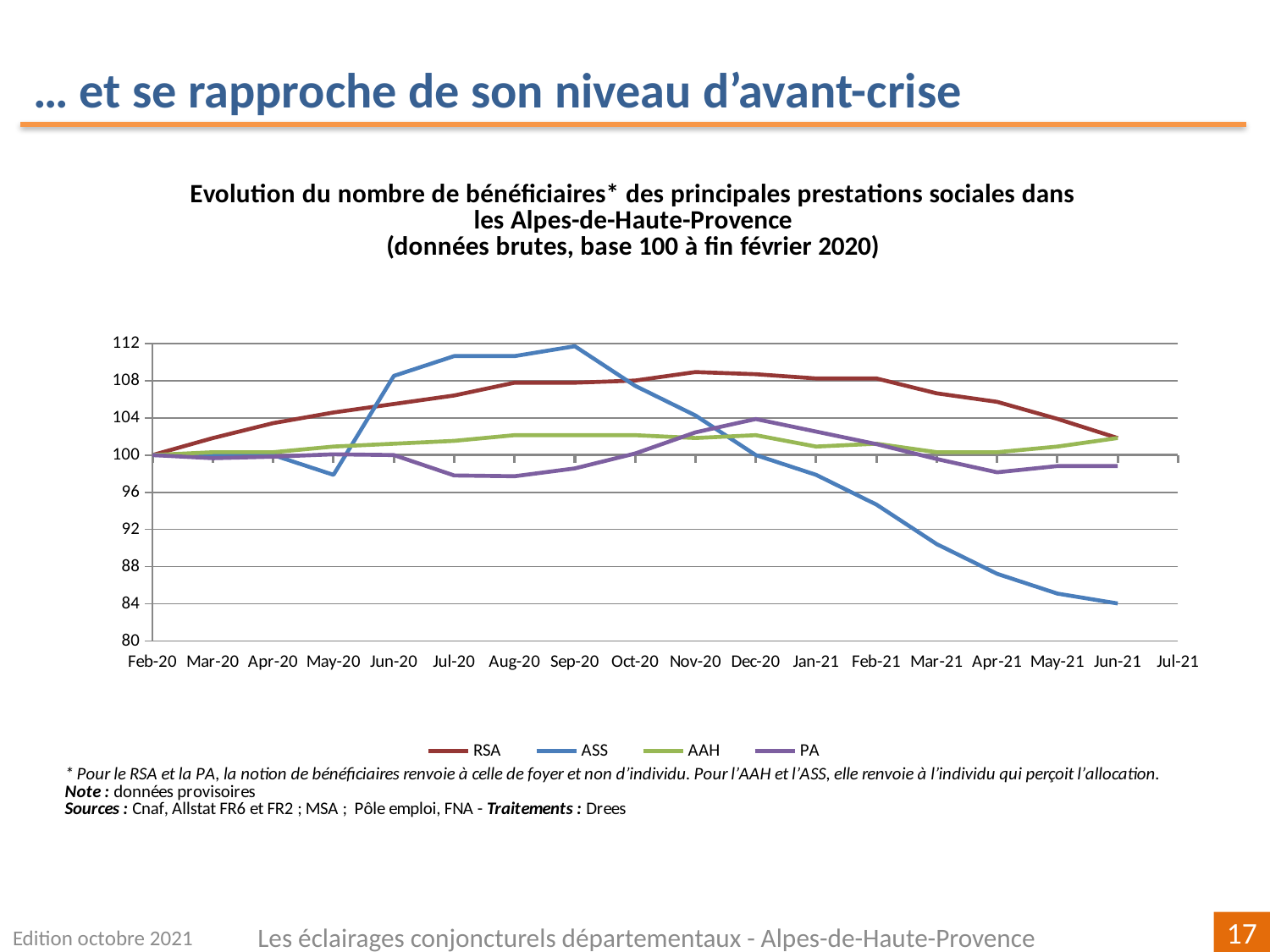
Is the value of the PA series at Jul-20 greater or less than 100? less Does the ASS series rise or fall between Sep-20 and Jun-21? fall Which series has the highest value at Sep-20? ASS At Jan-21, which series has the larger value, RSA or ASS? RSA How many series does the legend list? 4 Which series are listed in the legend? RSA, ASS, AAH, PA What kind of chart is shown on the slide? line chart Is the value of the ASS series at Jun-21 greater or less than 88? less What is the value of the RSA series at Feb-20? 100 Which series has the lowest value at Jun-21? ASS How many month labels are shown on the x axis? 18 Is the value of the ASS series at Sep-20 greater or less than 108? greater